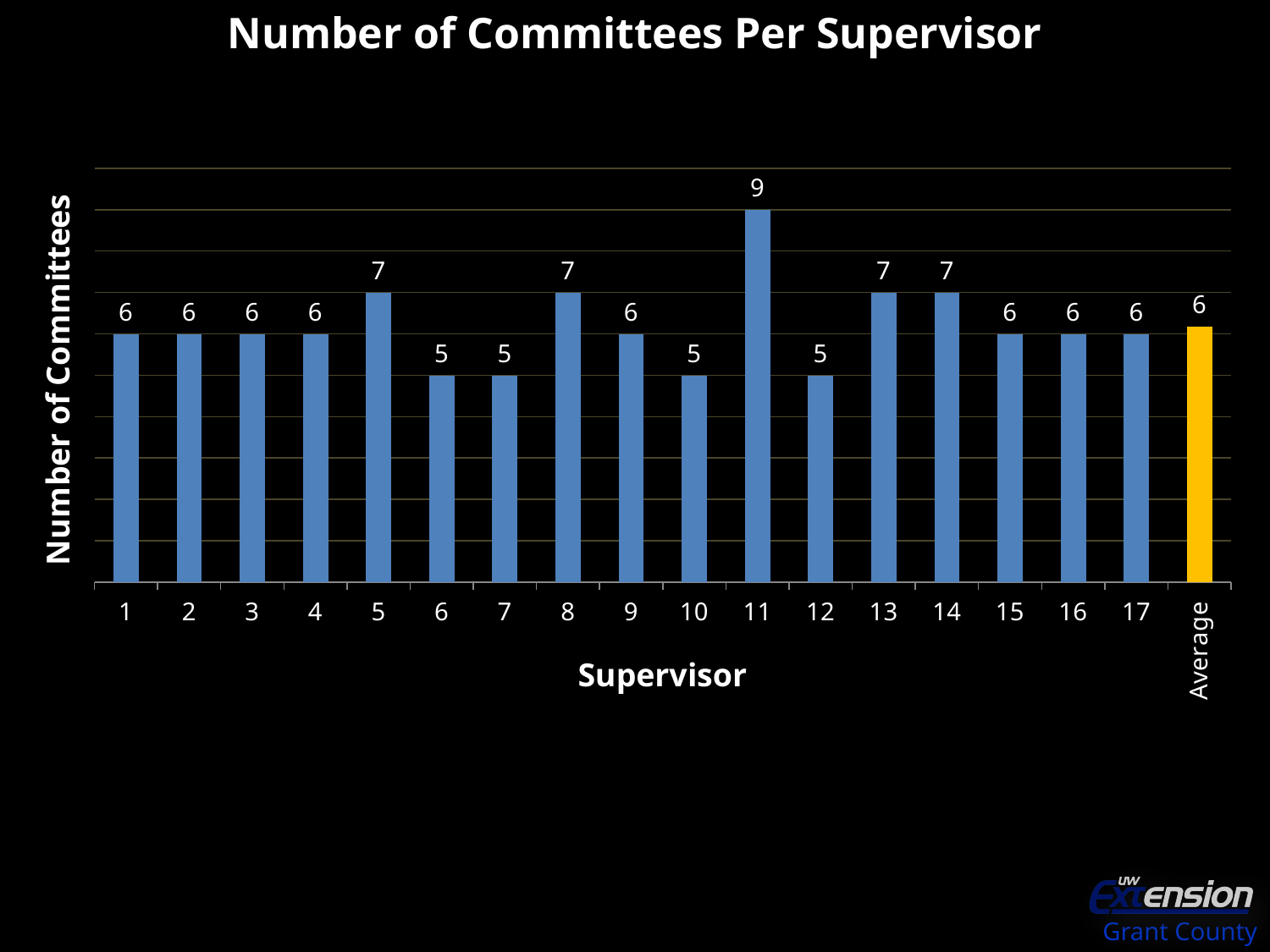
What type of chart is shown on the slide? Bar chart What is the title of the chart? Number of Committees Per Supervisor What is the number of committees for supervisor 5? 7 What is the difference in number of committees between supervisor 13 and supervisor 6? 2 Which supervisor serves on the most committees? 11 What is the number of committees for supervisor 11? 9 Who serves on more committees, supervisor 8 or supervisor 9? Supervisor 8 What value is shown for the Average bar? 6 How many bars are plotted in the chart, including the Average bar? 18 What is the number of committees for supervisor 10? 5 Who serves on more committees, supervisor 7 or supervisor 14? Supervisor 14 What is the difference in number of committees between supervisor 11 and supervisor 12? 4